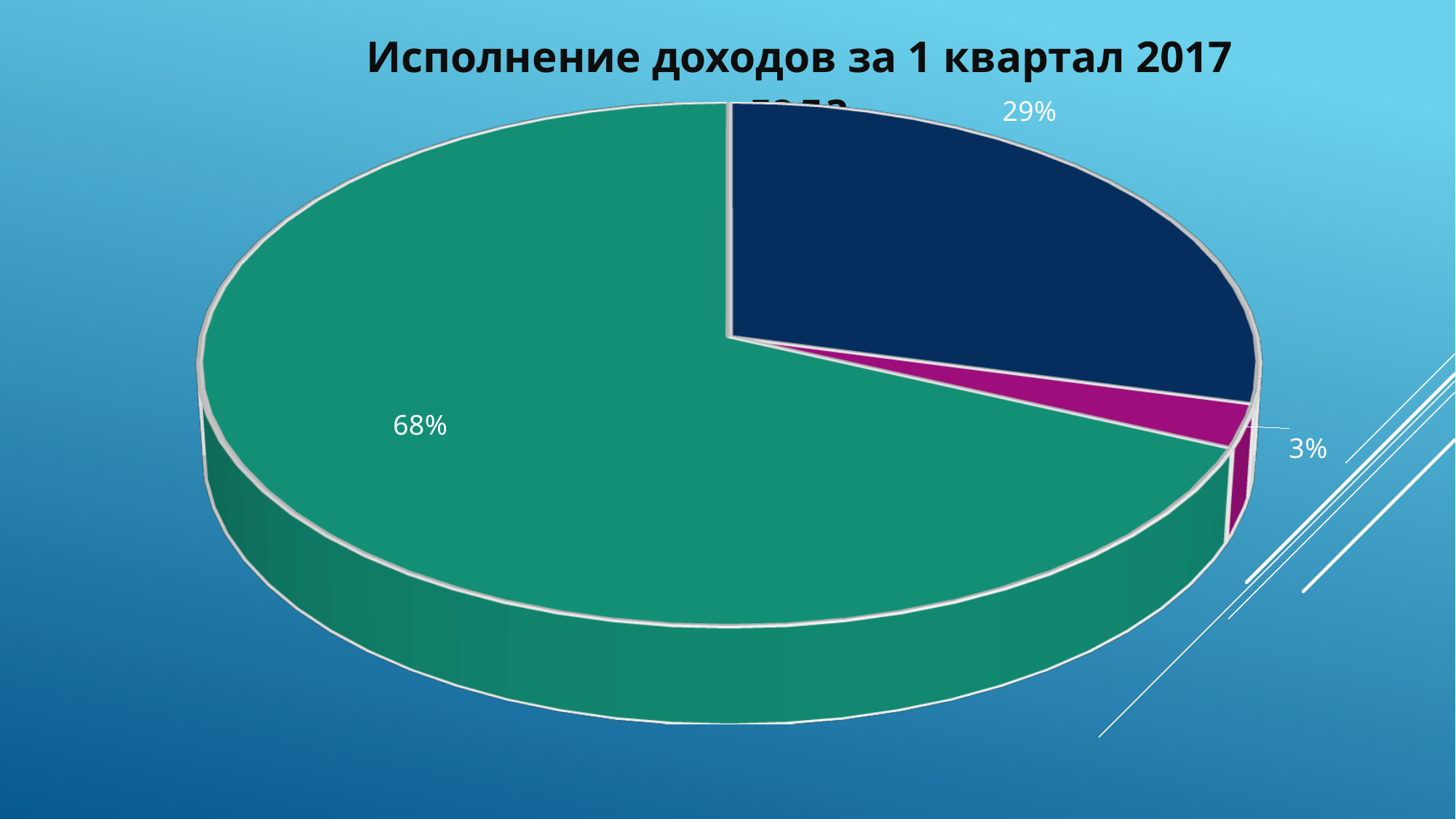
Which is larger, the dark blue slice or the magenta slice? the dark blue slice What percentage is shown for the green slice of the pie chart? 68% What is the difference in percentage points between the green slice and the dark blue slice? 39 What is the difference in percentage points between the dark blue slice and the magenta slice? 26 What percentage is shown for the dark blue slice of the pie chart? 29% What share of the pie does the dark blue slice represent? 29% What is the title of the chart? Исполнение доходов за 1 квартал 2017 года Which slice of the pie chart is the smallest? the magenta slice (3%) What percentage is shown for the magenta slice of the pie chart? 3% Which slice of the pie chart is the largest? the green slice (68%) How many slices does the pie chart have? 3 What kind of chart is shown on the slide? pie chart